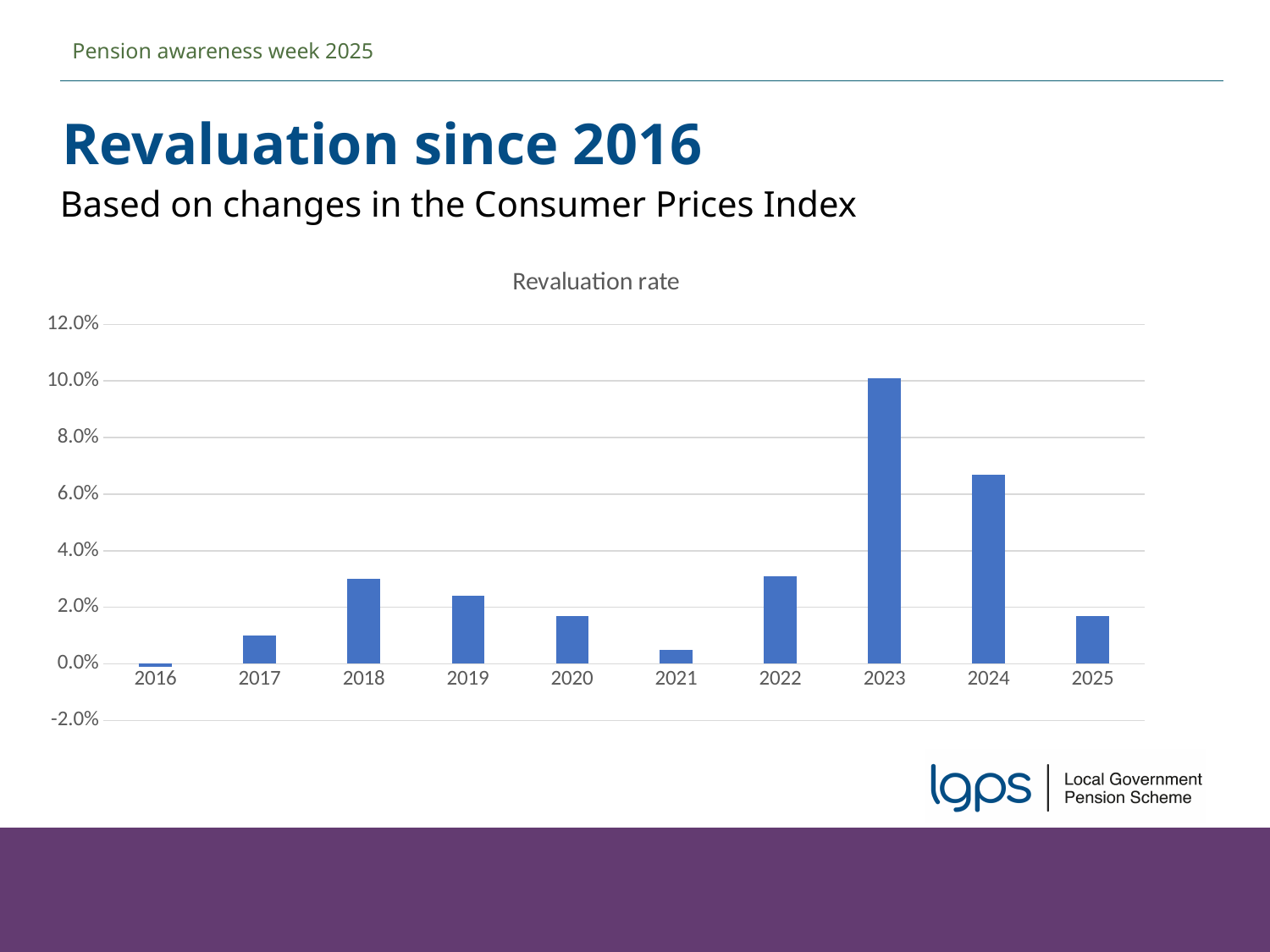
Is the revaluation rate for 2023 greater or less than 8.0%? greater Which year has the higher revaluation rate, 2018 or 2021? 2018 Which year has the lowest revaluation rate? 2016 How many years are plotted on the chart? 10 Is the revaluation rate for 2021 greater or less than 2.0%? less What kind of chart is shown on the slide? bar chart Is the revaluation rate for 2018 greater or less than 2.0%? greater Which year has the higher revaluation rate, 2023 or 2024? 2023 What is the title of the chart? Revaluation rate Do the revaluation rates rise or fall from 2023 to 2025? fall Which year has the highest revaluation rate? 2023